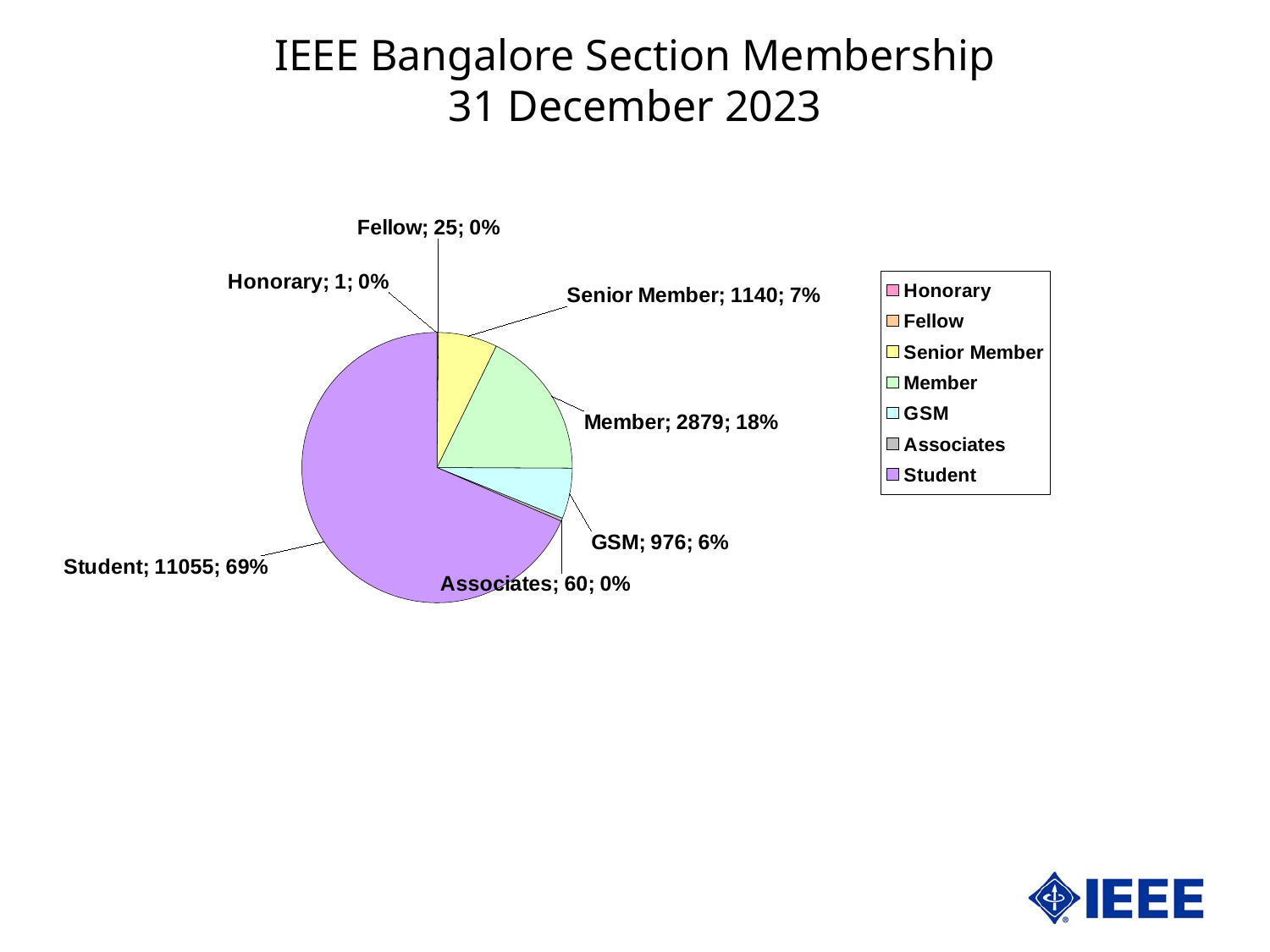
Which category has the largest slice of the pie? Student Which is larger, the value for GSM or the value for Senior Member? Senior Member How many entries does the legend list? 7 What is the title of the chart? IEEE Bangalore Section Membership 31 December 2023 How many members are in the Student category? 11055 What is the value for Senior Member? 1140 Which category has the smallest value? Honorary What share of the pie does GSM represent? 6% What share of the pie does the Member category represent? 18% What kind of chart is shown on the slide? pie chart How many categories does the pie chart have? 7 What is the difference between the Member and Senior Member values? 1739